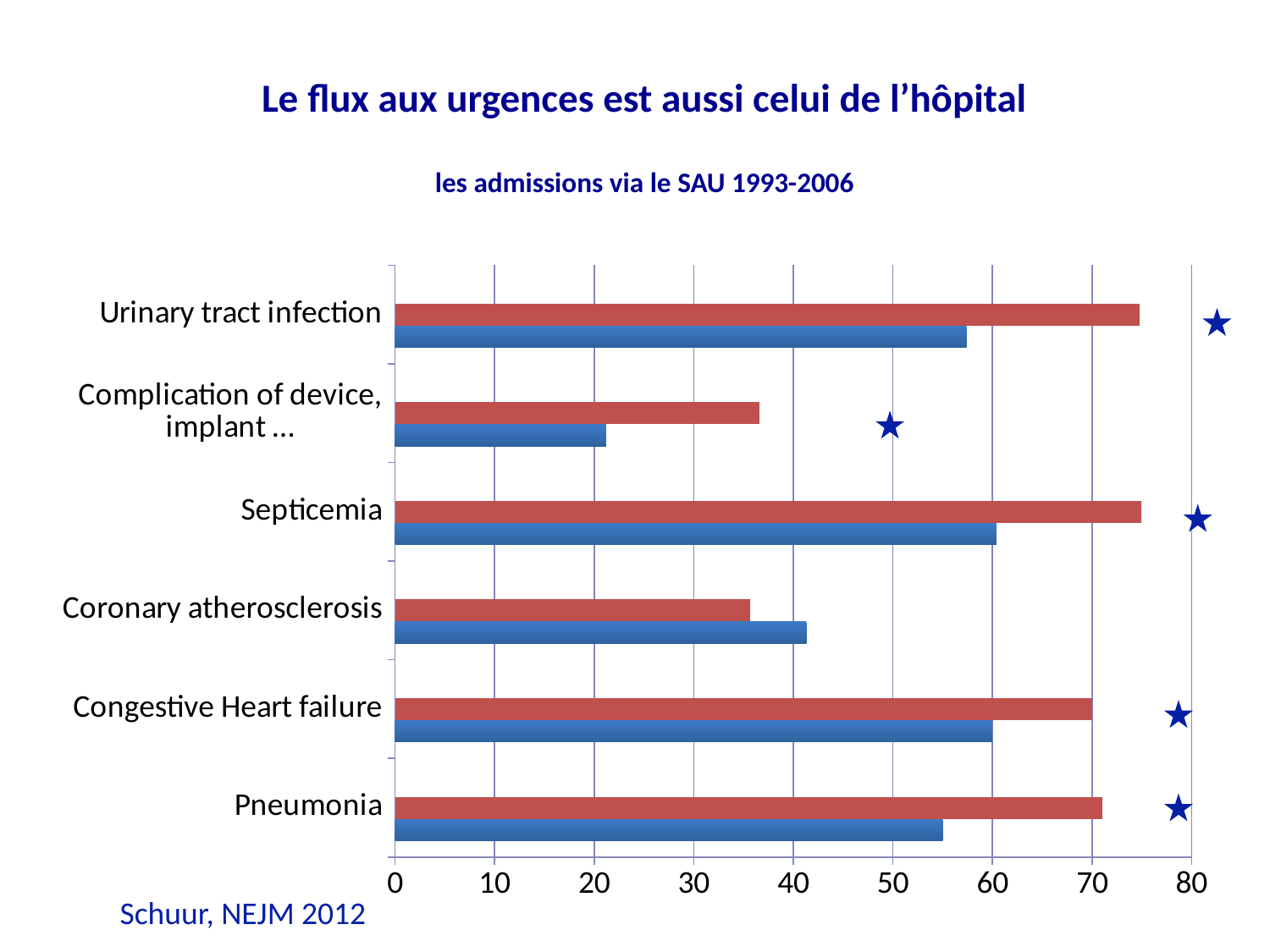
Is the red bar for Urinary tract infection greater or less than 70? greater What is the title of the chart? les admissions via le SAU 1993-2006 Is the blue bar for Complication of device, implant … greater or less than 30? less Is the red bar for Coronary atherosclerosis greater or less than 40? less For Coronary atherosclerosis, which bar is longer, the red one or the blue one? the blue one Which category has the lowest blue bar? Complication of device, implant … For Urinary tract infection, which bar is longer, the red one or the blue one? the red one How many categories are shown on the chart? 6 What source is cited below the chart? Schuur, NEJM 2012 What kind of chart is shown on the slide? bar chart